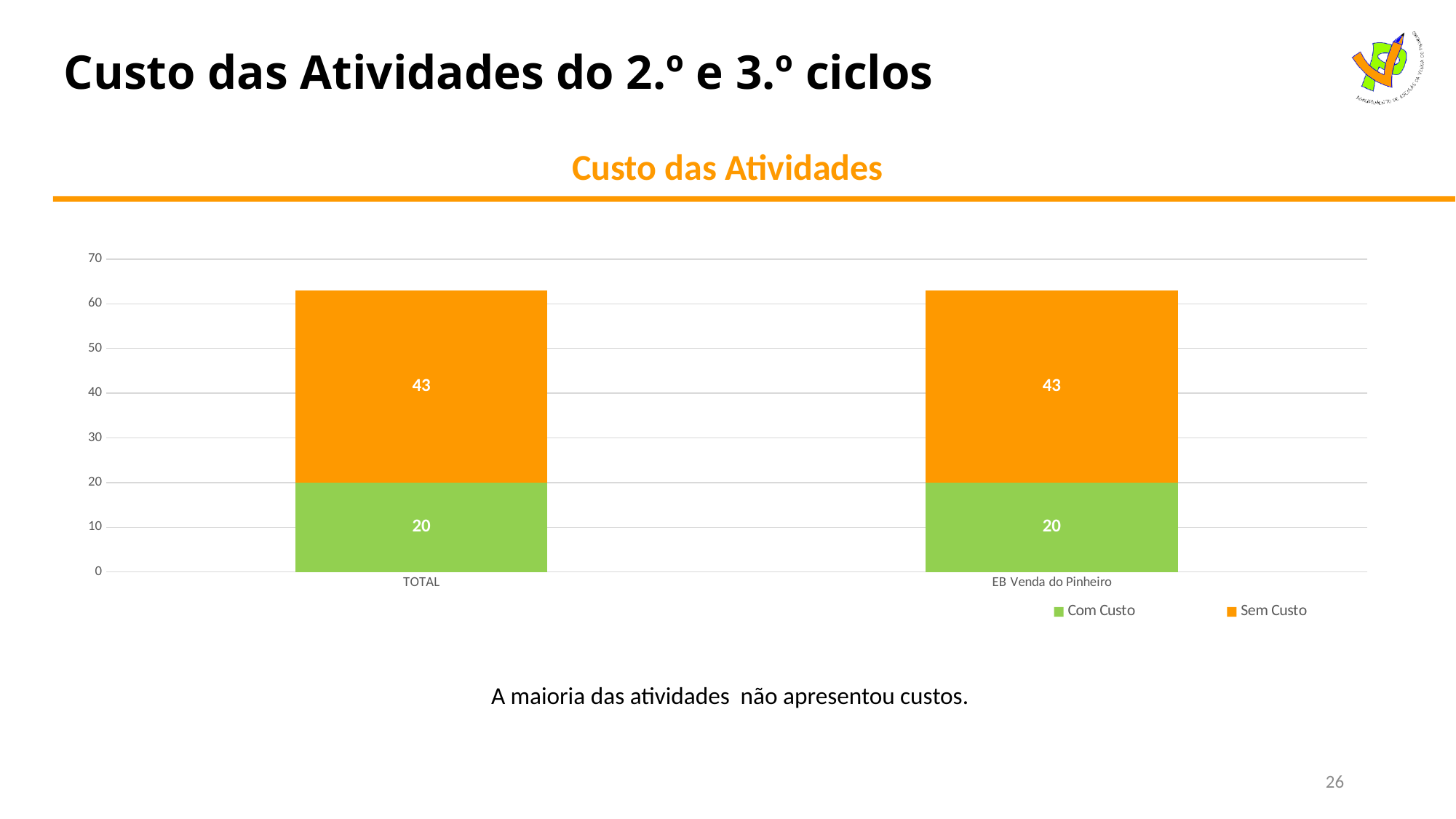
What is the value of Sem Custo for EB Venda do Pinheiro? 43 What kind of chart is shown? Stacked bar chart What is the value of Sem Custo for TOTAL? 43 What is the difference between Sem Custo and Com Custo for TOTAL? 23 How many categories are shown on the x axis? 2 How many series does the legend list? 2 What is the total of the stacked bar for TOTAL? 63 What is the total of the stacked bar for EB Venda do Pinheiro? 63 For EB Venda do Pinheiro, which is larger, Com Custo or Sem Custo? Sem Custo What is the title of the chart? Custo das Atividades What is the value of Com Custo for TOTAL? 20 What is the value of Com Custo for EB Venda do Pinheiro? 20